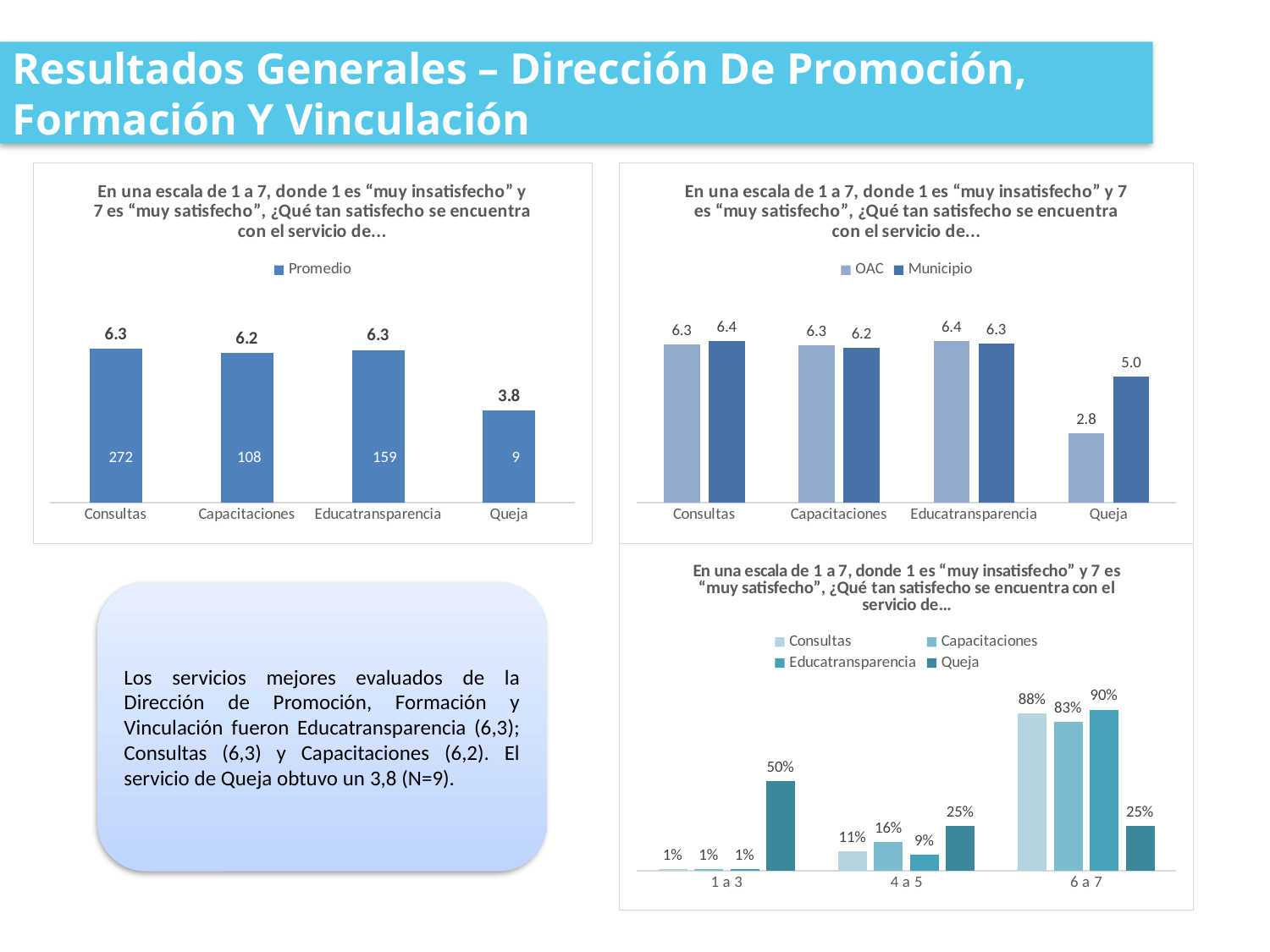
In the top-left chart (Promedio), which category has the lowest average? Queja In the top-right chart (OAC and Municipio), how many series does the legend list? 2 What type of chart is the bottom-right chart? Bar chart In the bottom-right chart, what percentage of Queja responses fall in the 1 a 3 range? 50% In the top-left chart (Promedio), what number is printed inside the Consultas bar? 272 In the top-left chart (Promedio), what is the average satisfaction value for Queja? 3.8 In the top-left chart (Promedio), what is the difference between the averages for Consultas and Queja? 2.5 In the bottom-right chart, which service has the highest percentage in the 6 a 7 range? Educatransparencia In the top-left chart (Promedio), how many categories are shown on the x axis? 4 In the top-right chart (OAC and Municipio), which is larger for Queja: OAC or Municipio? Municipio In the top-right chart (OAC and Municipio), what is the Municipio value for Educatransparencia? 6.3 In the top-right chart (OAC and Municipio), what is the OAC value for Queja? 2.8